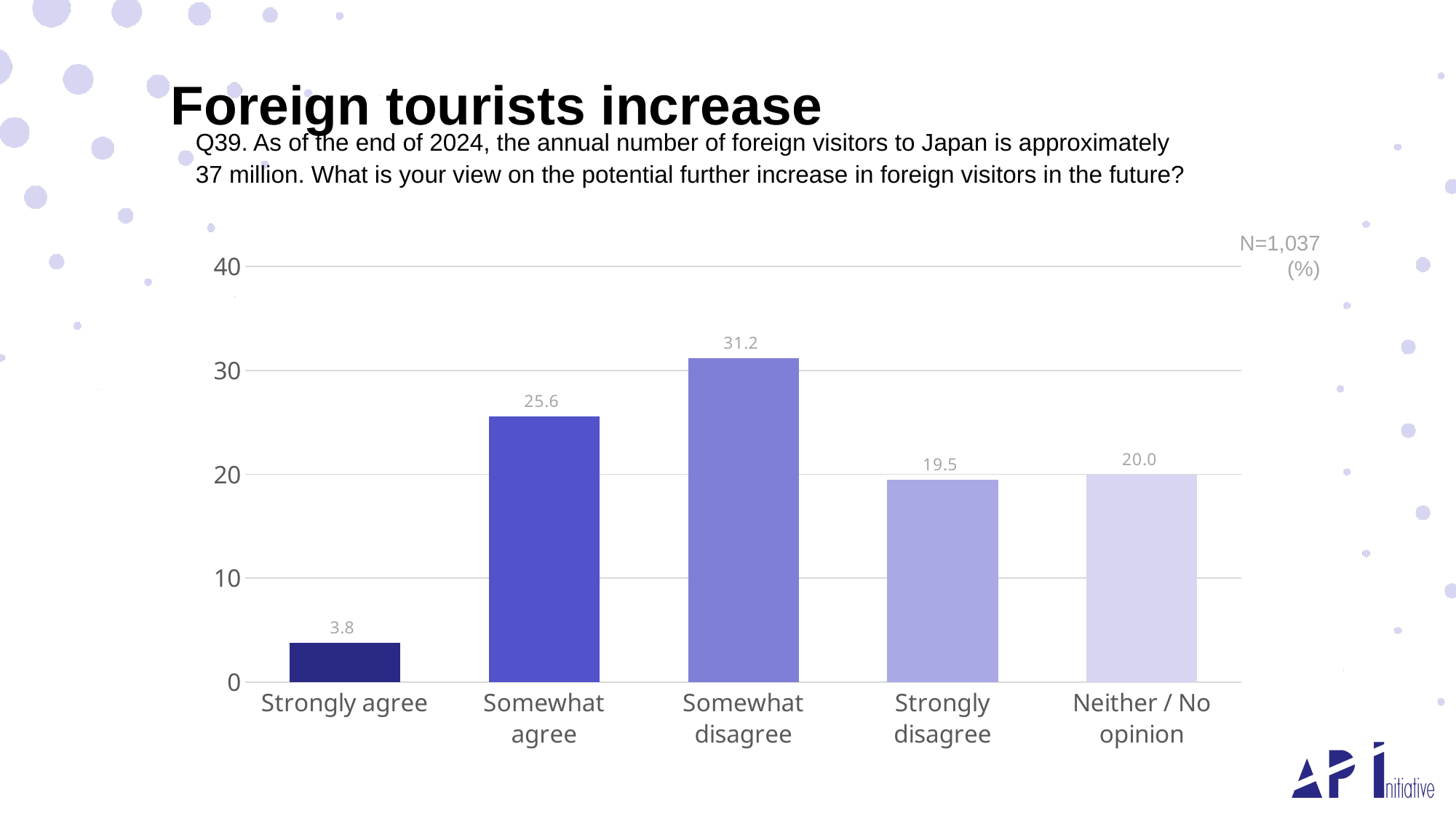
What is the difference between Somewhat disagree and Somewhat agree? 5.6 Which category has the lowest value? Strongly agree What is the value for Neither / No opinion? 20.0 What is the value for Strongly agree? 3.8 What kind of chart is shown on the slide? bar chart Which is larger, Somewhat agree or Strongly disagree? Somewhat agree What is the difference between Neither / No opinion and Strongly disagree? 0.5 What is the sample size (N) shown on the chart? N=1,037 Which category has the highest value? Somewhat disagree Is the value for Somewhat agree greater or less than 20? greater How many categories are shown on the x axis? 5 What is the value for Somewhat disagree? 31.2